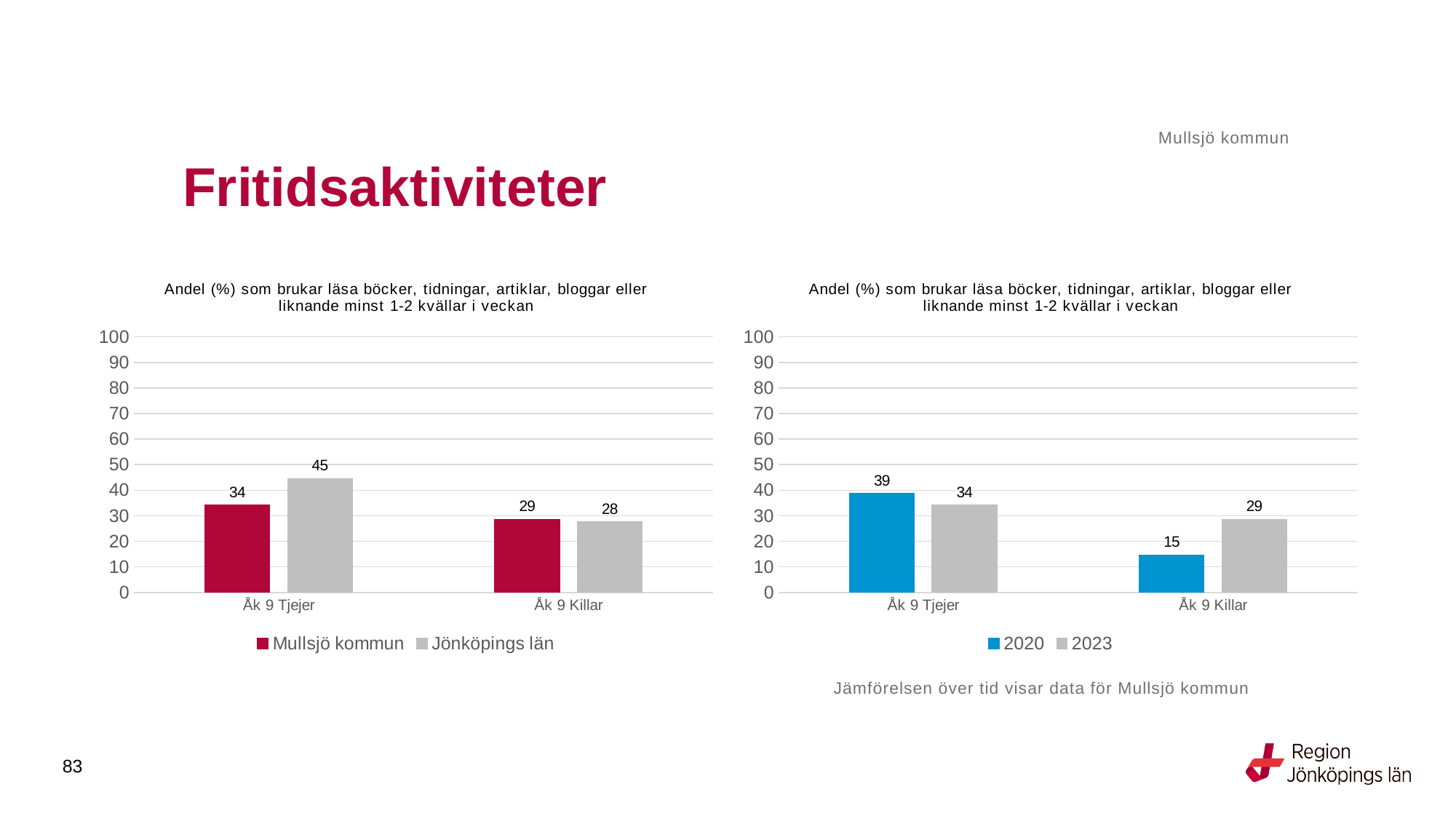
In the left chart, which is larger for Åk 9 Killar: Mullsjö kommun or Jönköpings län? Mullsjö kommun In the right chart, what is the value for 2023 for Åk 9 Tjejer? 34 In the right chart, which is larger for Åk 9 Tjejer: 2020 or 2023? 2020 In the right chart, how many categories are shown on the x axis? 2 In the right chart, what is the difference between 2023 and 2020 for Åk 9 Killar? 14 In the right chart, which bar is the lowest? 2020, Åk 9 Killar In the left chart, how many series does the legend list? 2 In the left chart, what is the value for Jönköpings län for Åk 9 Killar? 28 In the left chart, what is the difference between Jönköpings län and Mullsjö kommun for Åk 9 Tjejer? 11 In the right chart, what is the value for 2020 for Åk 9 Killar? 15 What kind of chart is the right chart? Bar chart In the left chart, what is the value for Mullsjö kommun for Åk 9 Tjejer? 34